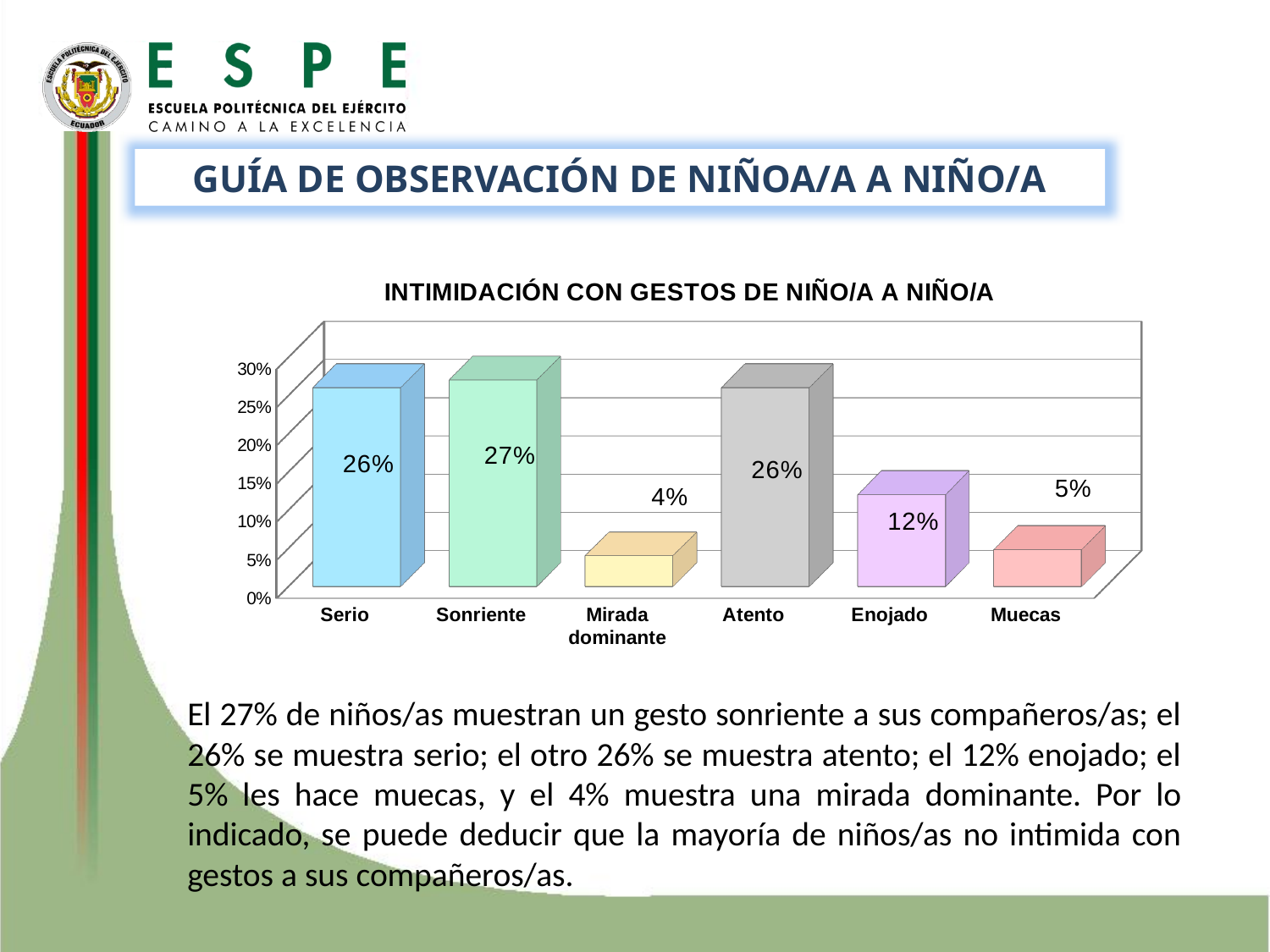
What is the value for Sonriente? 27% What is the value for Mirada dominante? 4% What is the title of the chart? INTIMIDACIÓN CON GESTOS DE NIÑO/A A NIÑO/A Which is larger, the value for Enojado or the value for Muecas? Enojado What is the value for Enojado? 12% What kind of chart is shown? Bar chart How many categories are shown on the x axis? 6 Is the value for Atento greater or less than 20%? greater Which category has the highest value? Sonriente What is the value for Muecas? 5% Which category has the lowest value? Mirada dominante What is the difference between the values for Serio and Enojado? 14%